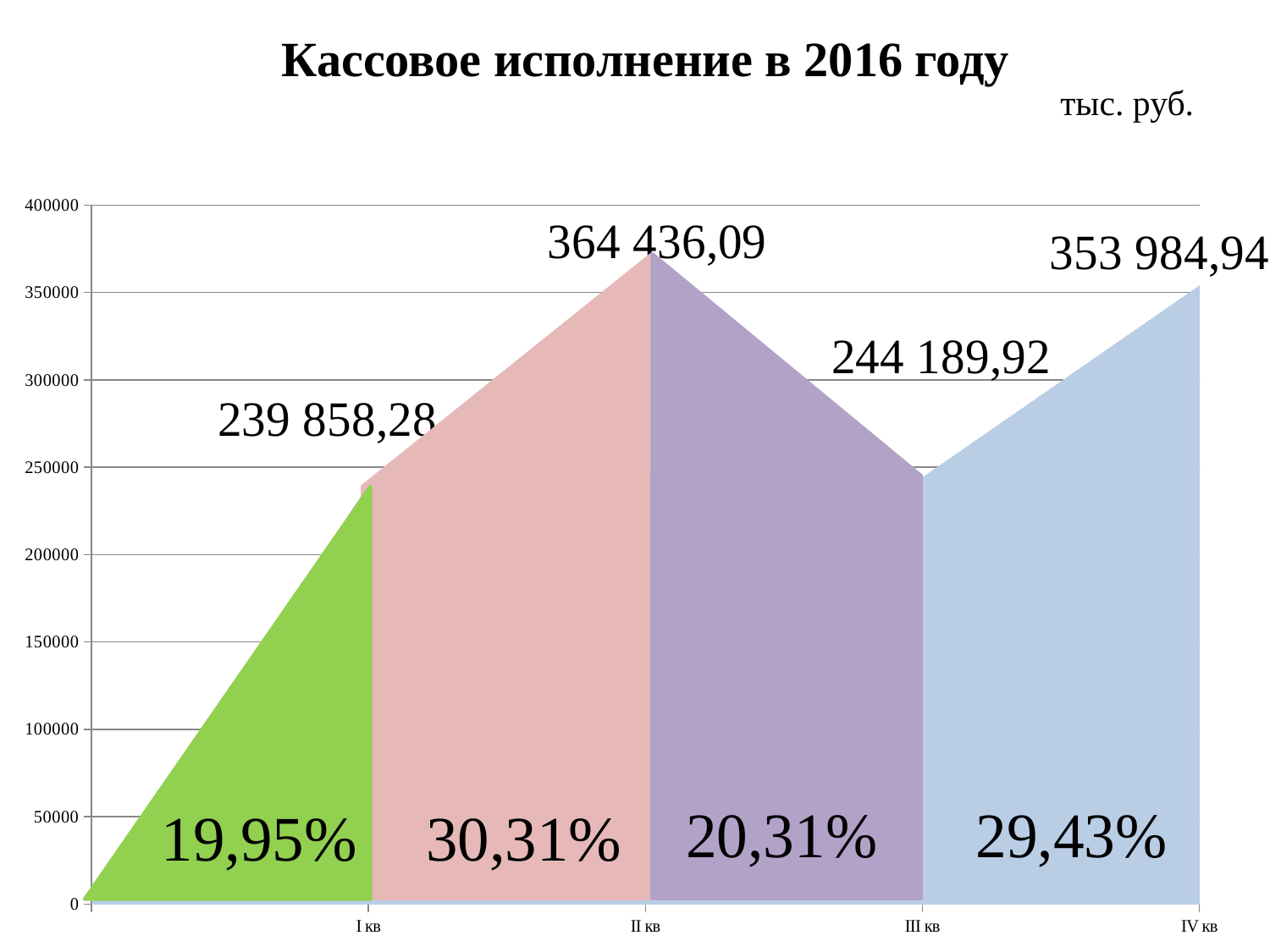
What percentage is shown for III кв? 20,31% What is the difference between the values for II кв and I кв? 124 577,81 What type of chart is shown on the slide? area chart How many quarters are plotted on the chart? 4 What is the title of the chart? Кассовое исполнение в 2016 году Is the value for III кв greater or less than 250000? less What is the value for II кв? 364 436,09 What is the value for IV кв? 353 984,94 Which quarter has the highest value? II кв Which is larger, the value for II кв or the value for IV кв? II кв What is the value for I кв? 239 858,28 Which quarter has the lowest value? I кв